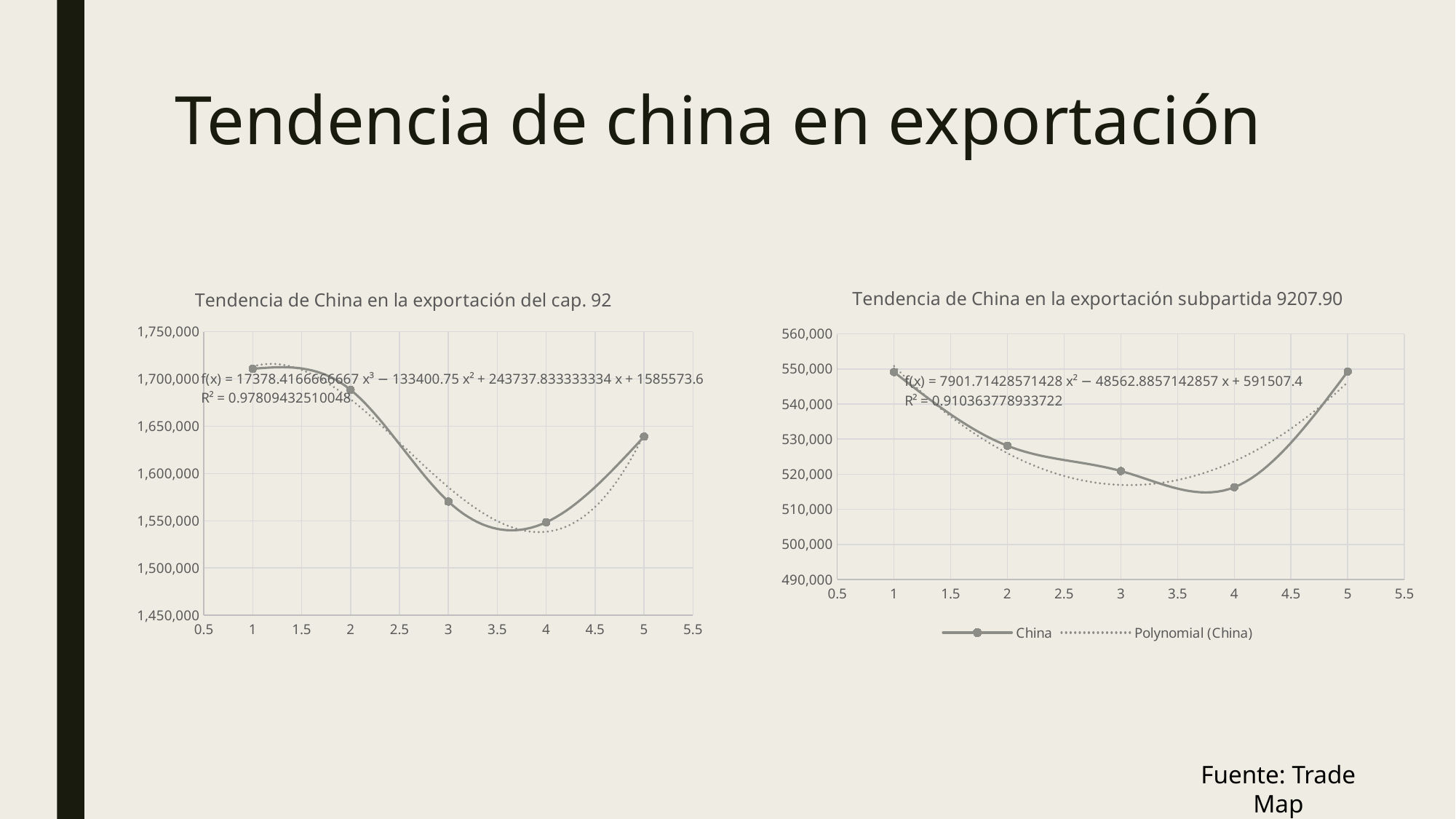
In the left chart 'Tendencia de China en la exportación del cap. 92', at which x value is the plotted value highest? 1 In the right chart 'Tendencia de China en la exportación subpartida 9207.90', how many data points are plotted for China? 5 In the right chart 'Tendencia de China en la exportación subpartida 9207.90', how many series does the legend list? 2 In the left chart 'Tendencia de China en la exportación del cap. 92', is the value at x = 3 greater or less than 1,600,000? less What kind of chart is the left chart, 'Tendencia de China en la exportación del cap. 92'? Line chart In the left chart 'Tendencia de China en la exportación del cap. 92', how many data points are plotted? 5 In the right chart 'Tendencia de China en la exportación subpartida 9207.90', do the China values rise or fall from x = 1 to x = 4? fall What are the two legend entries in the right chart 'Tendencia de China en la exportación subpartida 9207.90'? China and Polynomial (China) In the left chart 'Tendencia de China en la exportación del cap. 92', which is larger, the value at x = 3 or the value at x = 5? x = 5 In the right chart 'Tendencia de China en la exportación subpartida 9207.90', is the value at x = 4 greater or less than 520,000? less In the left chart 'Tendencia de China en la exportación del cap. 92', is the value at x = 2 greater or less than 1,650,000? greater In the left chart 'Tendencia de China en la exportación del cap. 92', at which x value is the plotted value lowest? 4